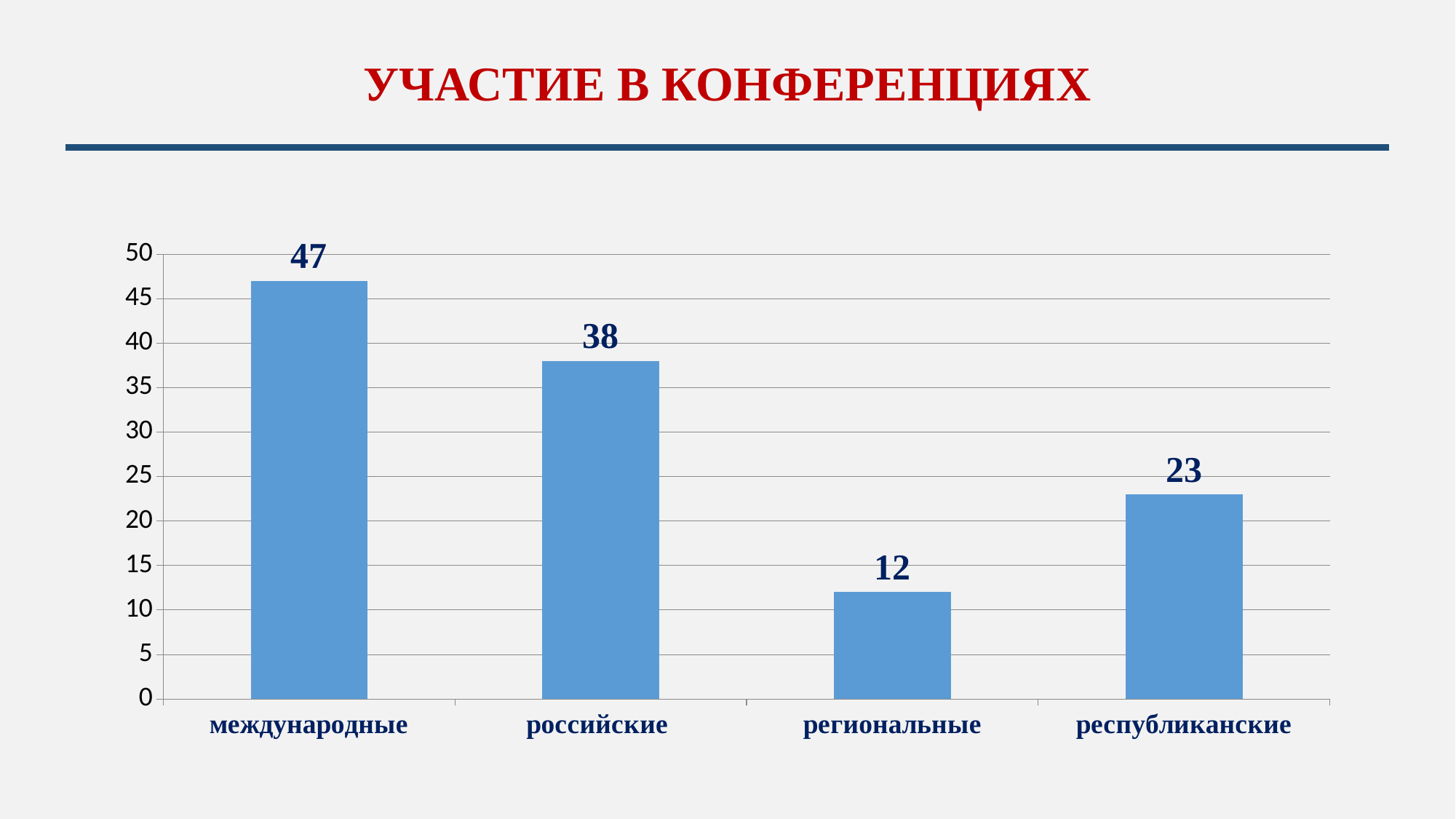
What is the value for республиканские? 23 What is the title of the slide? УЧАСТИЕ В КОНФЕРЕНЦИЯХ What is the difference between the values for республиканские and региональные? 11 What is the value for российские? 38 Which category has the lowest value? региональные Which category has the highest value? международные How many categories are shown on the x axis? 4 What is the value for международные? 47 Which is larger, the value for российские or the value for республиканские? российские What is the difference between the values for международные and российские? 9 What is the value for региональные? 12 What kind of chart is shown on the slide? bar chart